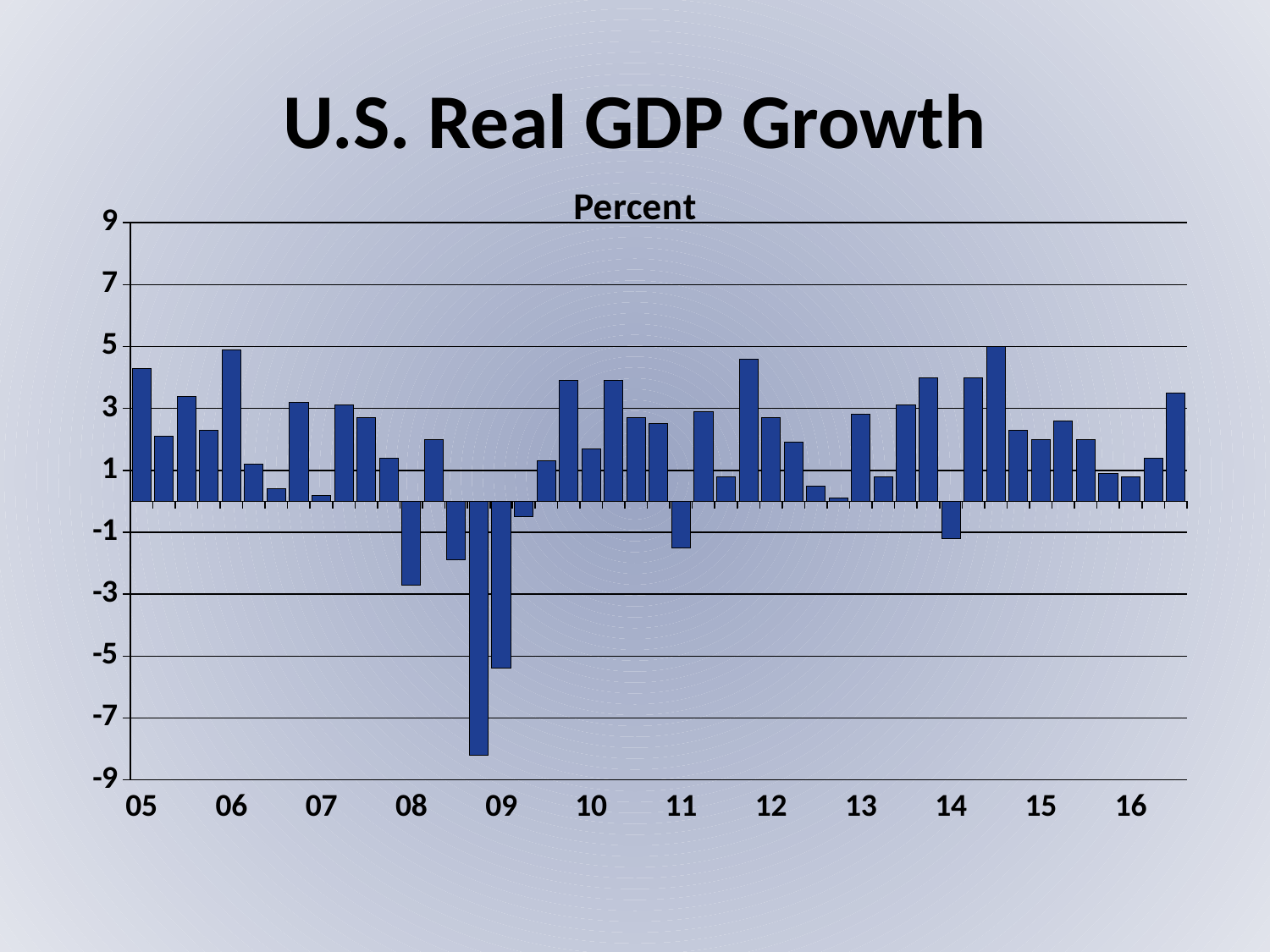
Is the value of the bar at the 12 label greater or less than 3? less Is the value of the bar at the 11 label greater or less than -1? less What unit label is shown above the chart's vertical axis? Percent Is the value of the bar at the 09 label greater or less than -3? less What is the title of the chart? U.S. Real GDP Growth How many year labels are shown along the x axis? 12 Which bar is taller, the one at the 12 label or the one at the 10 label? 12 What kind of chart is shown on the slide? Bar chart